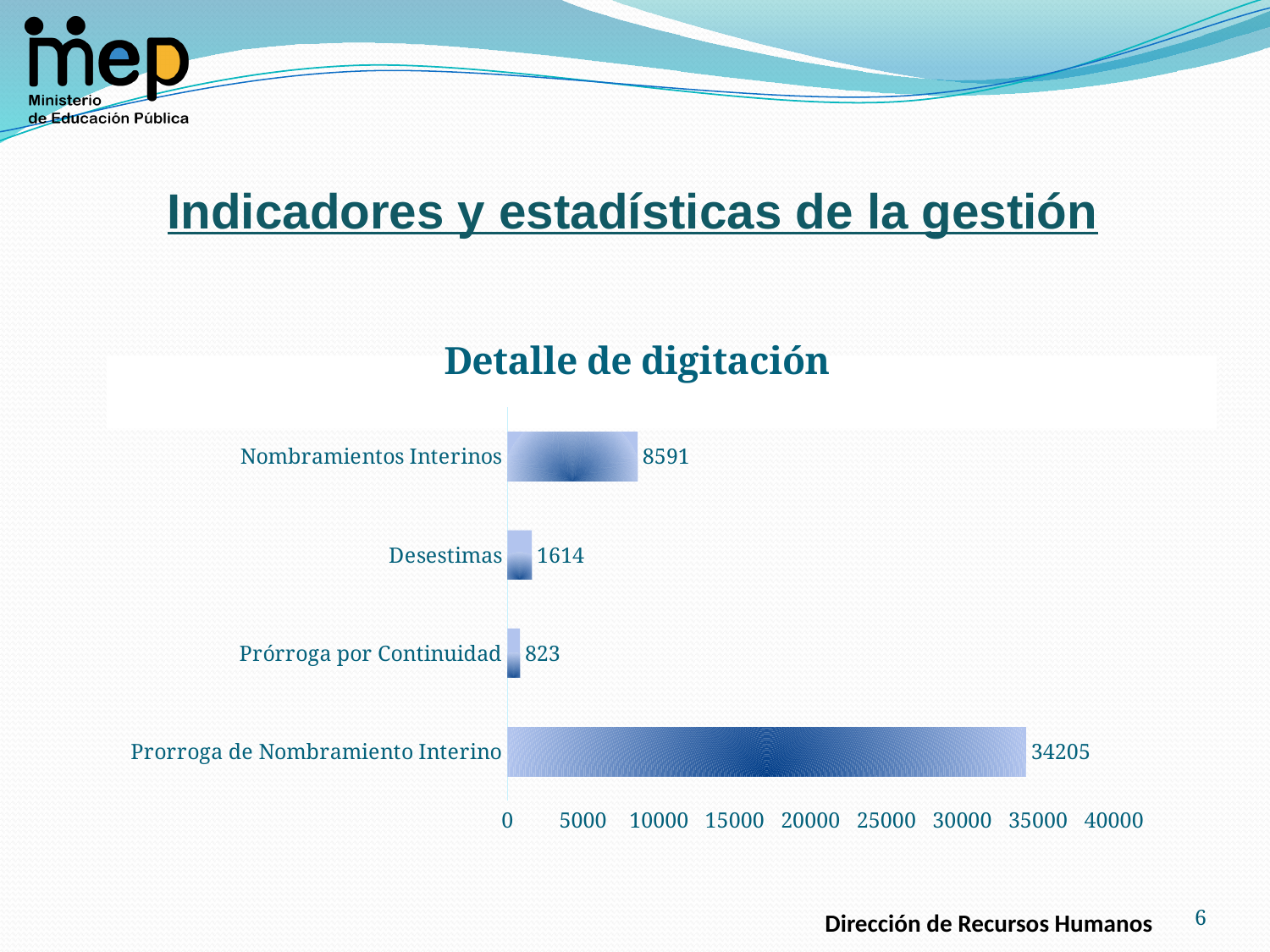
What is the value for Prórroga por Continuidad? 823 What is the title of the chart? Detalle de digitación Which category has the highest value? Prorroga de Nombramiento Interino What is the value for Desestimas? 1614 Is the value for Prorroga de Nombramiento Interino greater or less than 30000? greater What is the value for Nombramientos Interinos? 8591 Which is larger, the value for Desestimas or the value for Prórroga por Continuidad? Desestimas What kind of chart is shown on the slide? bar chart What is the value for Prorroga de Nombramiento Interino? 34205 Which category has the lowest value? Prórroga por Continuidad What is the difference between the values for Nombramientos Interinos and Desestimas? 6977 How many categories are shown in the chart? 4